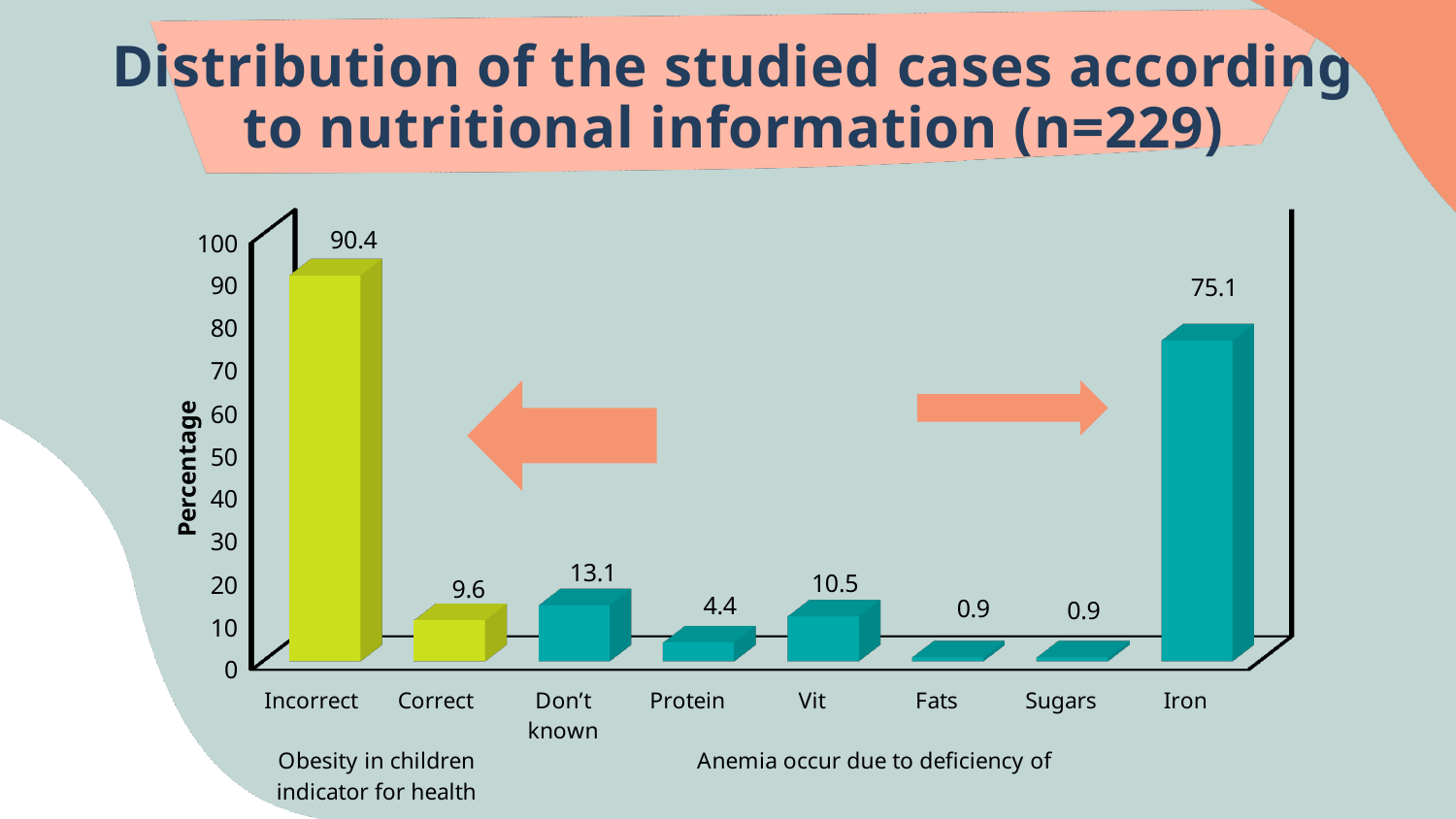
What kind of chart is this? bar chart What is the value for Don't known? 13.1 Is the value for Iron greater or less than 70? greater How many categories are shown on the x axis? 8 What is the difference between the values for Incorrect and Correct? 80.8 Which is larger, the value for Don't known or the value for Vit? Don't known Which category has the highest value? Incorrect What is the value for Iron? 75.1 What is the value for Incorrect? 90.4 What is the value for Protein? 4.4 What is the label on the vertical axis? Percentage What is the difference between the values for Iron and Vit? 64.6